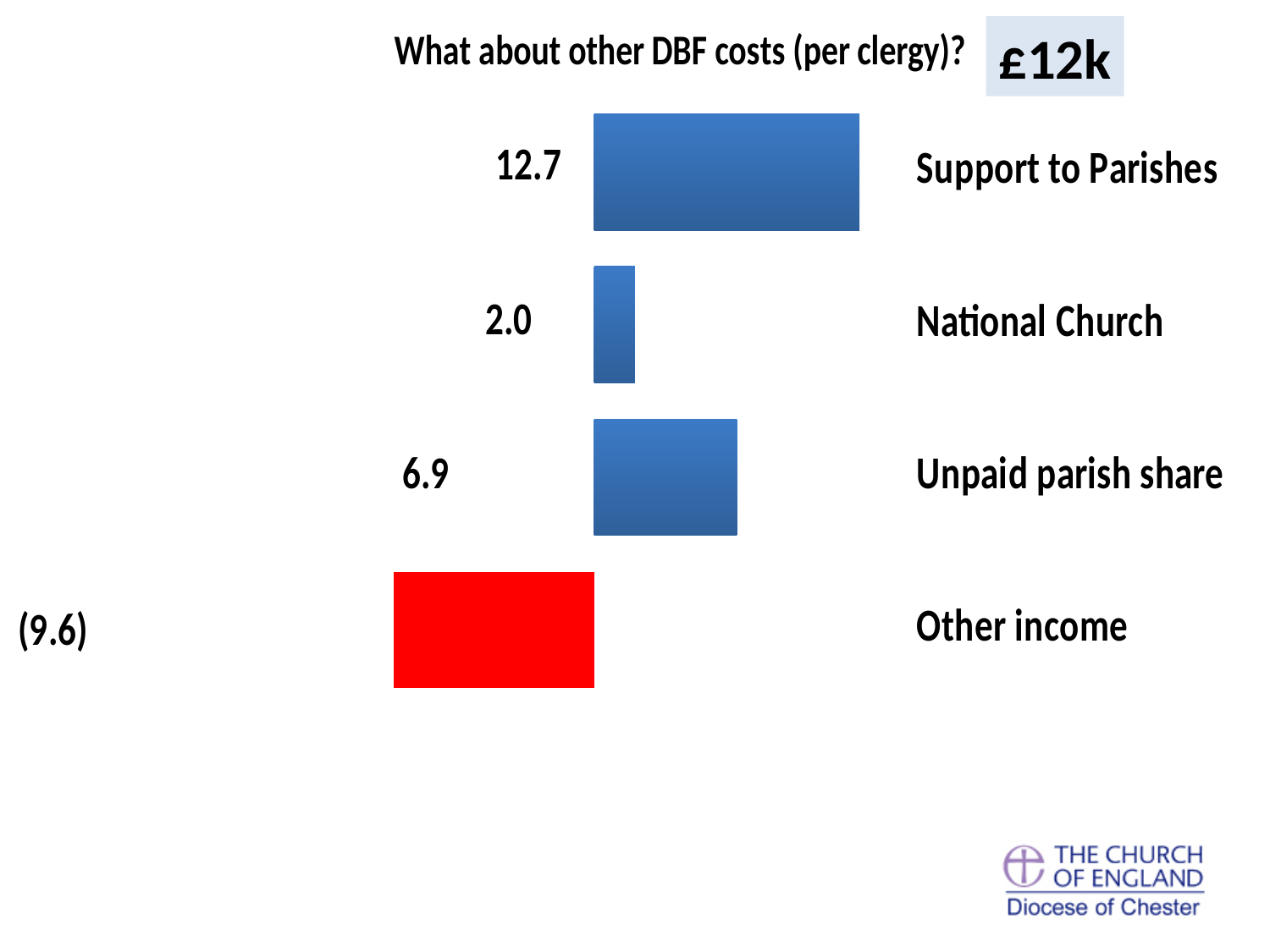
What is the difference between the values for Support to Parishes and Unpaid parish share? 5.8 What is the value for National Church? 2.0 What kind of chart is shown on the slide? Bar chart Which category has the smallest positive bar? National Church What is the title of the chart? What about other DBF costs (per clergy)? How many categories are shown in the chart? 4 What is the value for Unpaid parish share? 6.9 What value is shown for Other income? (9.6) Which category is drawn with a red bar? Other income Which category has the largest positive bar? Support to Parishes What is the value for Support to Parishes? 12.7 Which is larger, the value for Unpaid parish share or the value for National Church? Unpaid parish share